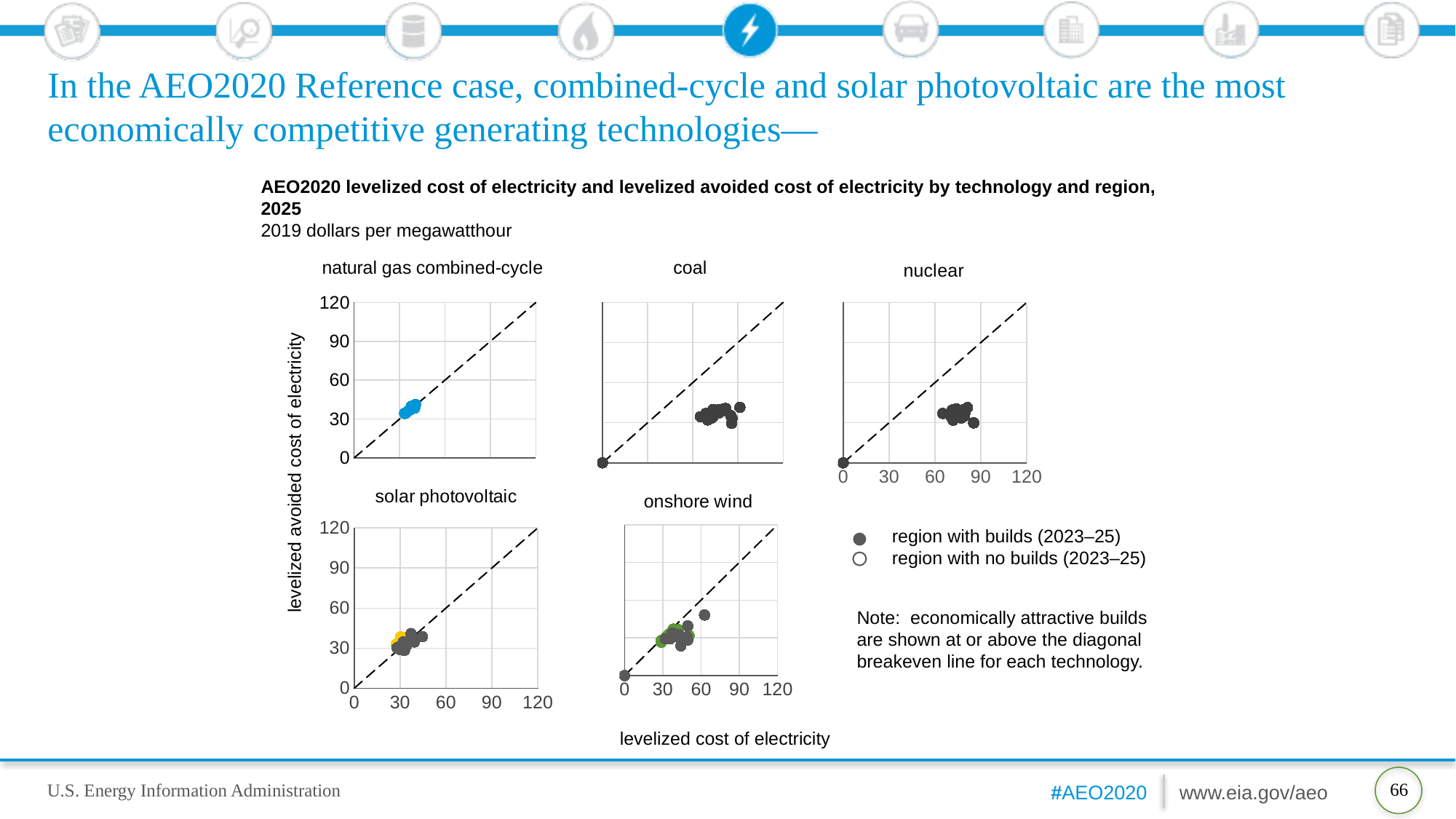
In the solar photovoltaic chart, are the levelized avoided cost of electricity values of the plotted regions greater or less than 90? less Which technology has the higher levelized cost of electricity for its plotted regions, coal or natural gas combined-cycle? coal In the natural gas combined-cycle chart, are the levelized cost of electricity values of the plotted regions greater or less than 60? less What is the label of the vertical axis shared by the charts? levelized avoided cost of electricity What kind of chart is used for each of the five technology panels on the slide? scatter chart In the nuclear chart, are the levelized cost of electricity values of the plotted regions greater or less than 30? greater How many technology charts are shown on the slide? 5 How many entries does the legend list? 2 Which technology has the higher levelized cost of electricity for its plotted regions, nuclear or solar photovoltaic? nuclear What unit is given for the values in the charts? 2019 dollars per megawatthour